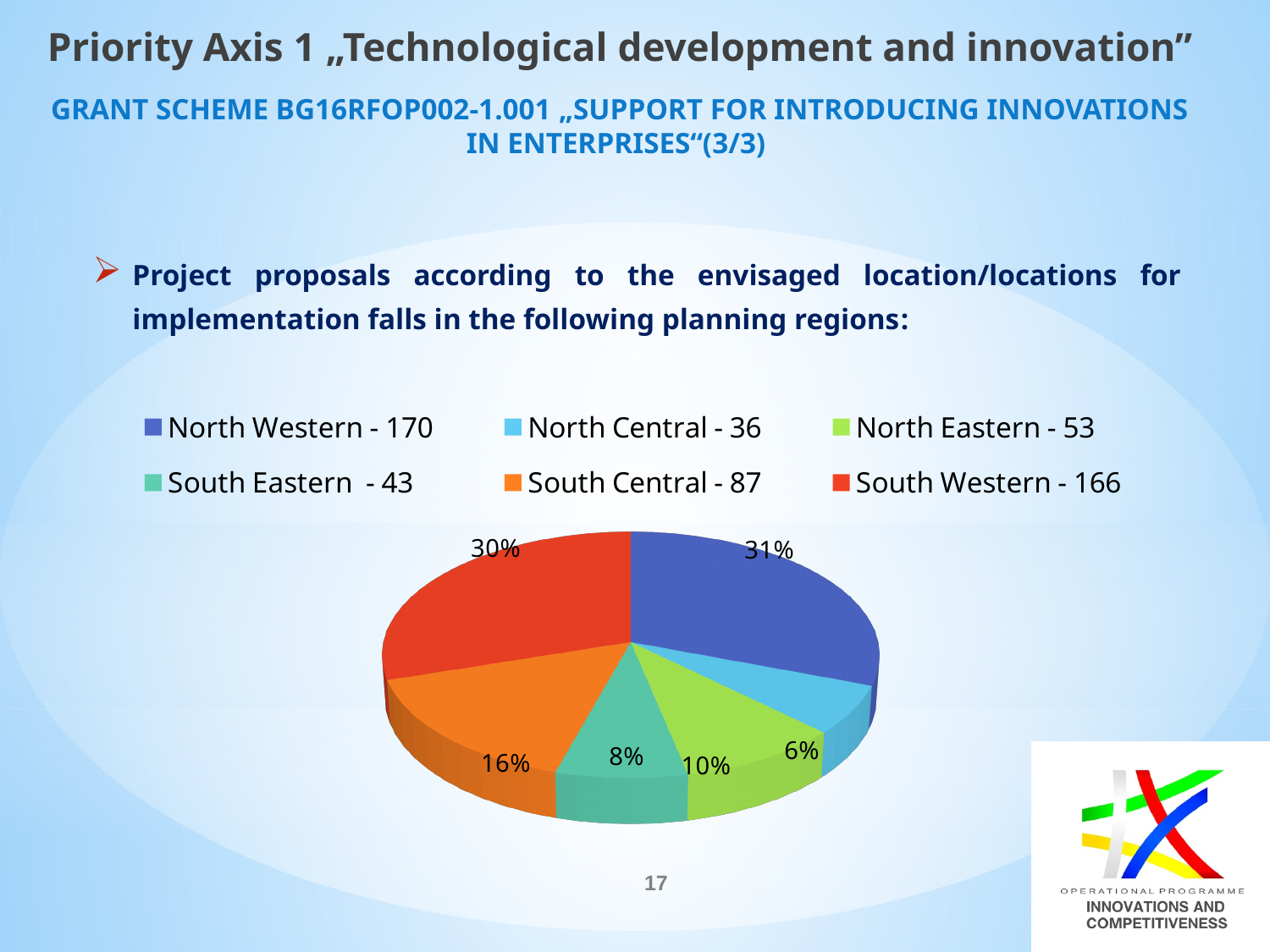
What share of the pie does South Western hold? 30% Which colour represents South Central in the pie chart? orange What share of the pie does North Western hold? 31% How many slices does the pie chart have? 6 How many project proposals does the legend give for North Eastern? 53 What kind of chart is shown on the slide? pie chart How many project proposals does the legend give for South Eastern? 43 Which region has the largest slice of the pie? North Western What share of the pie does South Central hold? 16% What is the difference between the number of proposals for North Western and South Western according to the legend? 4 Which region has the smallest slice of the pie? North Central